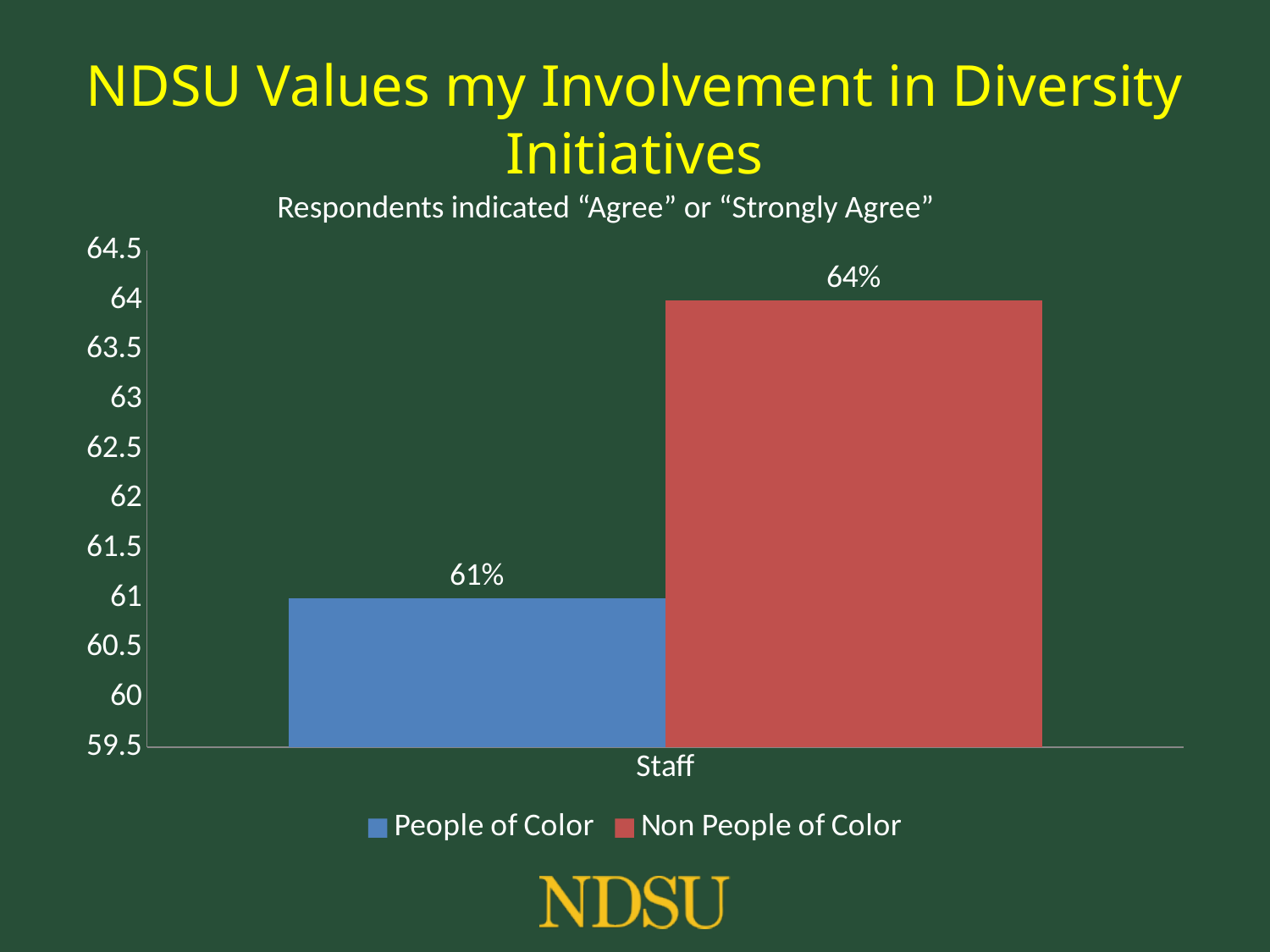
What percentage of People of Color staff indicated "Agree" or "Strongly Agree"? 61% Which series has the lower value for Staff? People of Color Is the value for Non People of Color greater or less than 63? greater Is the value for People of Color larger or smaller than the value for Non People of Color? smaller How many categories are shown on the x axis? 1 Is the value for People of Color greater or less than 62? less What percentage of Non People of Color staff indicated "Agree" or "Strongly Agree"? 64% How many series does the legend list? 2 Which series has the higher value for Staff? Non People of Color What kind of chart is shown on the slide? bar chart What colour is the bar for Non People of Color? red What is the difference between the Non People of Color and People of Color values for Staff? 3%